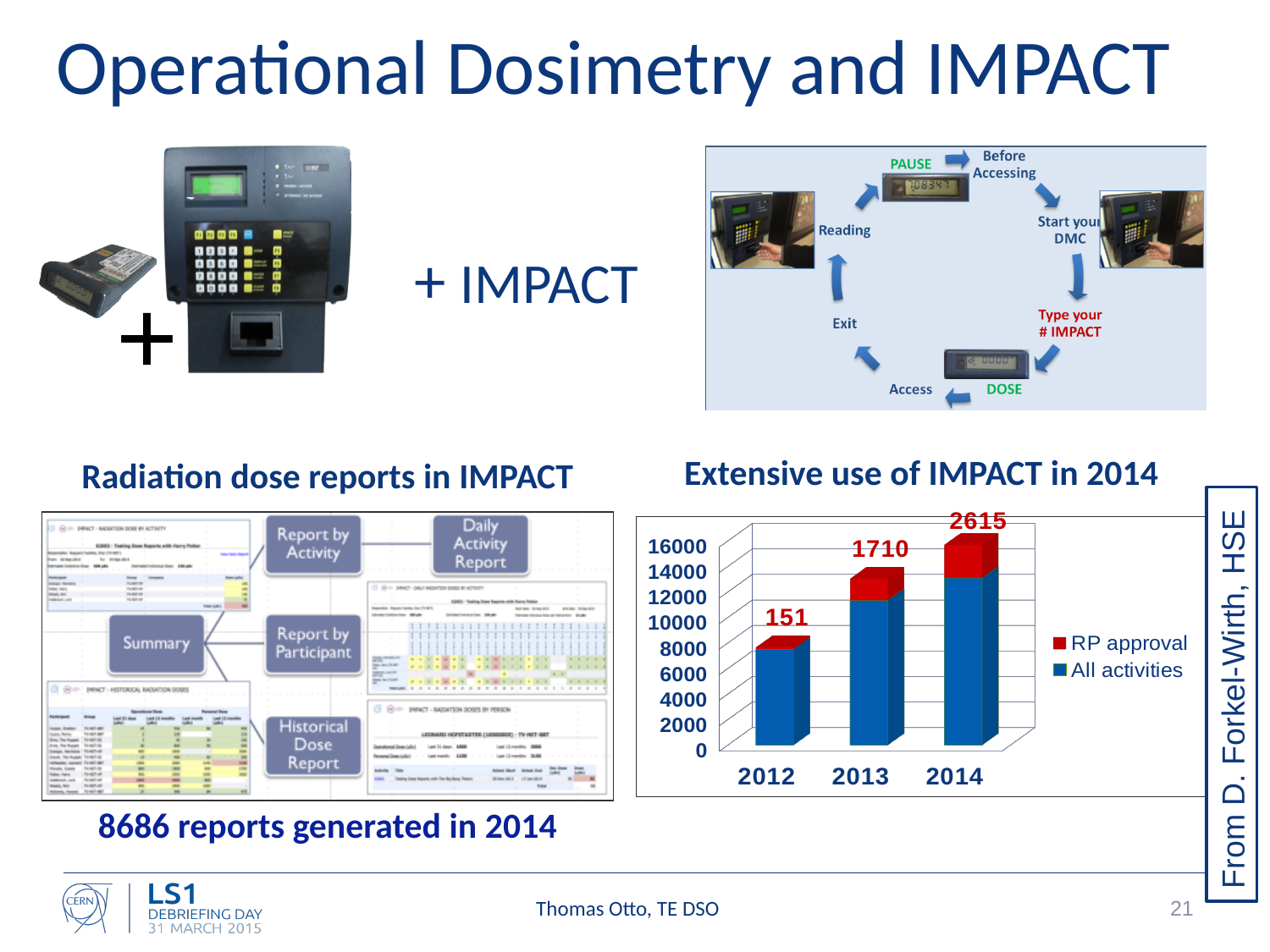
Which colour represents 'All activities' in the 'Extensive use of IMPACT in 2014' chart? blue In the 'Extensive use of IMPACT in 2014' chart, is the total height of the 2014 bar greater or less than 14000? greater How many series does the legend of the 'Extensive use of IMPACT in 2014' chart list? 2 Do the RP approval values rise or fall from 2012 to 2014 in the 'Extensive use of IMPACT in 2014' chart? rise What type of chart is shown under the title 'Extensive use of IMPACT in 2014'? bar chart What is the RP approval value for 2014 in the 'Extensive use of IMPACT in 2014' chart? 2615 What is the difference between the RP approval values for 2014 and 2013 in the 'Extensive use of IMPACT in 2014' chart? 905 What is the RP approval value for 2013 in the 'Extensive use of IMPACT in 2014' chart? 1710 What is the RP approval value for 2012 in the 'Extensive use of IMPACT in 2014' chart? 151 In which year is the RP approval value highest in the 'Extensive use of IMPACT in 2014' chart? 2014 In which year is the RP approval value lowest in the 'Extensive use of IMPACT in 2014' chart? 2012 How many years are shown on the x axis of the 'Extensive use of IMPACT in 2014' chart? 3